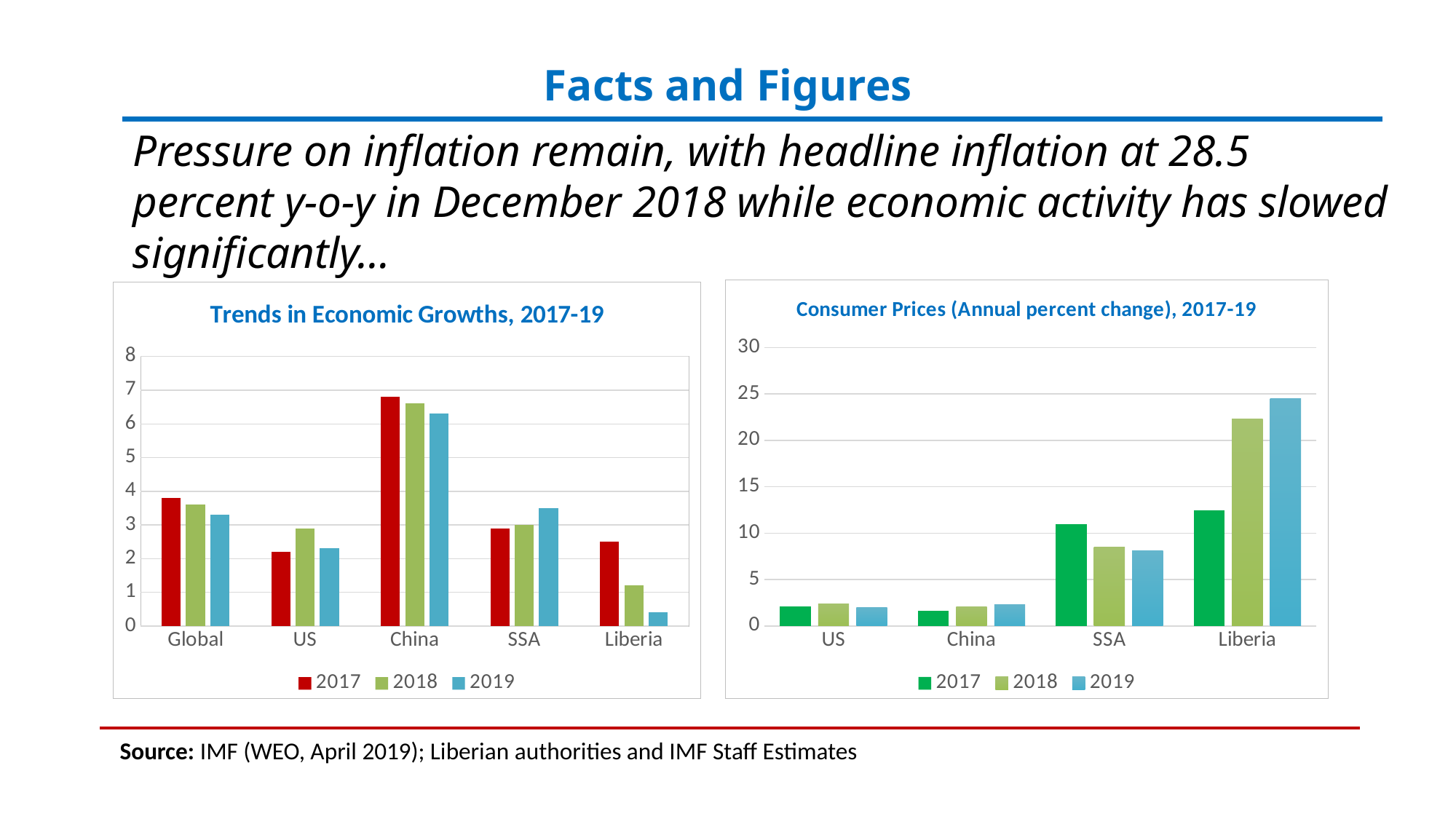
In the 'Consumer Prices (Annual percent change), 2017-19' chart, which is larger for 2018: SSA or Liberia? Liberia In the 'Consumer Prices (Annual percent change), 2017-19' chart, is the value for Liberia in 2019 greater or less than 20? greater In the 'Trends in Economic Growths, 2017-19' chart, which category has the highest value for 2017? China In the 'Consumer Prices (Annual percent change), 2017-19' chart, which category has the highest value for 2019? Liberia In the 'Trends in Economic Growths, 2017-19' chart, is the value for Liberia in 2019 greater or less than 1? less In the 'Trends in Economic Growths, 2017-19' chart, is the value for China in 2017 greater or less than 6? greater How many series does the legend of the 'Trends in Economic Growths, 2017-19' chart list? 3 What kind of chart is the 'Consumer Prices (Annual percent change), 2017-19' chart? bar chart In the 'Trends in Economic Growths, 2017-19' chart, do Liberia's values rise or fall from 2017 to 2019? fall How many categories are shown on the x axis of the 'Trends in Economic Growths, 2017-19' chart? 5 In the 'Trends in Economic Growths, 2017-19' chart, which category has the lowest value for 2019? Liberia In the 'Consumer Prices (Annual percent change), 2017-19' chart, do Liberia's values rise or fall from 2017 to 2019? rise